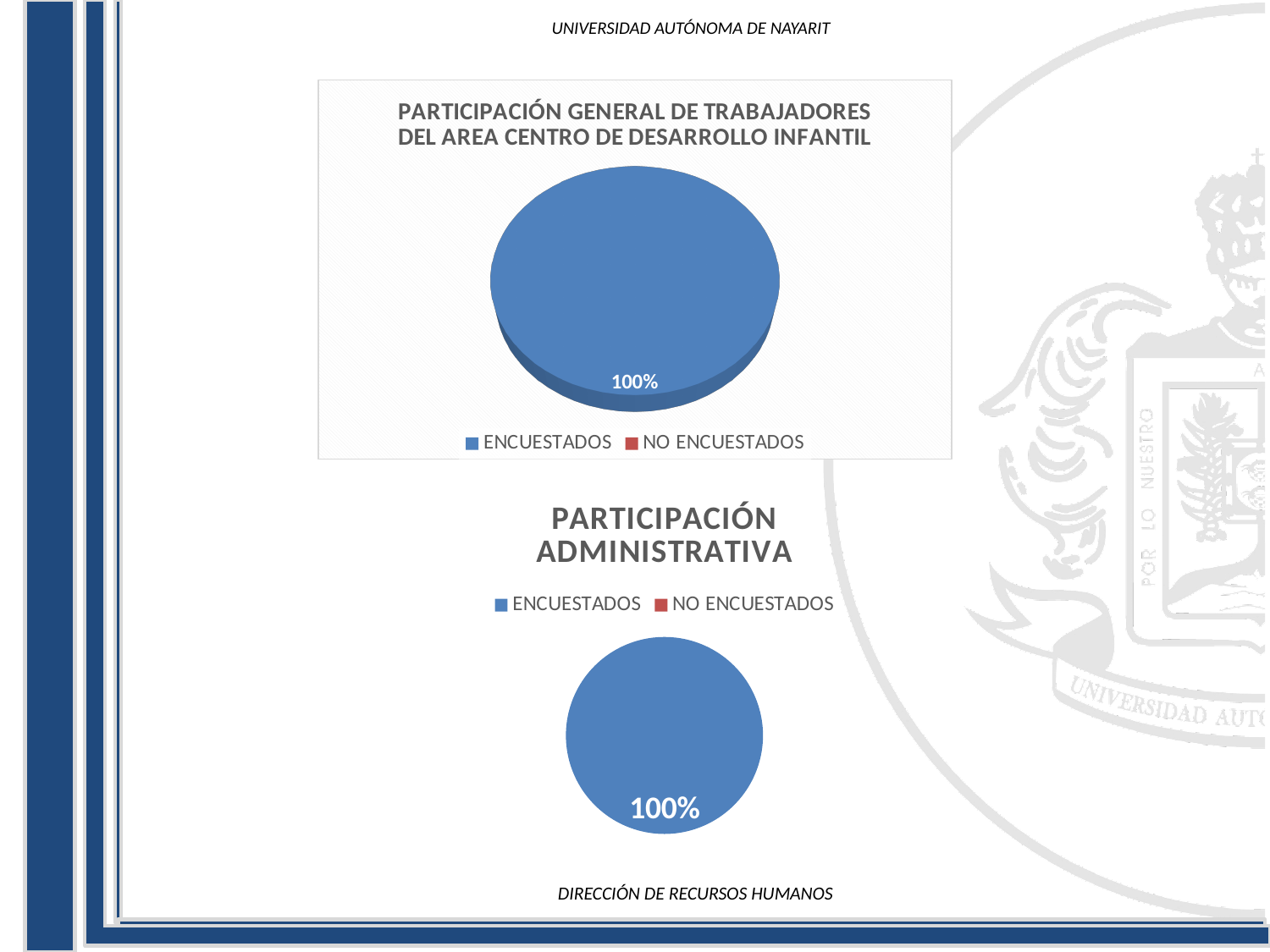
How many entries does the legend of the bottom chart, "PARTICIPACIÓN ADMINISTRATIVA", list? 2 What kind of chart is the top chart, "PARTICIPACIÓN GENERAL DE TRABAJADORES DEL AREA CENTRO DE DESARROLLO INFANTIL"? Pie chart In the top chart, "PARTICIPACIÓN GENERAL DE TRABAJADORES DEL AREA CENTRO DE DESARROLLO INFANTIL", which is larger, ENCUESTADOS or NO ENCUESTADOS? ENCUESTADOS What is the title of the bottom chart on the slide? PARTICIPACIÓN ADMINISTRATIVA In the chart titled "PARTICIPACIÓN ADMINISTRATIVA", what share of the pie is ENCUESTADOS? 100% In the bottom chart, "PARTICIPACIÓN ADMINISTRATIVA", which category makes up the largest share of the pie? ENCUESTADOS What kind of chart is the bottom chart, "PARTICIPACIÓN ADMINISTRATIVA"? Pie chart In the bottom chart, "PARTICIPACIÓN ADMINISTRATIVA", which is larger, ENCUESTADOS or NO ENCUESTADOS? ENCUESTADOS In the chart titled "PARTICIPACIÓN GENERAL DE TRABAJADORES DEL AREA CENTRO DE DESARROLLO INFANTIL", what share of the pie is ENCUESTADOS? 100% In the top chart, "PARTICIPACIÓN GENERAL DE TRABAJADORES DEL AREA CENTRO DE DESARROLLO INFANTIL", which category makes up the largest share of the pie? ENCUESTADOS How many entries does the legend of the top chart, "PARTICIPACIÓN GENERAL DE TRABAJADORES DEL AREA CENTRO DE DESARROLLO INFANTIL", list? 2 What colour represents NO ENCUESTADOS in the legend of the bottom chart, "PARTICIPACIÓN ADMINISTRATIVA"? Red